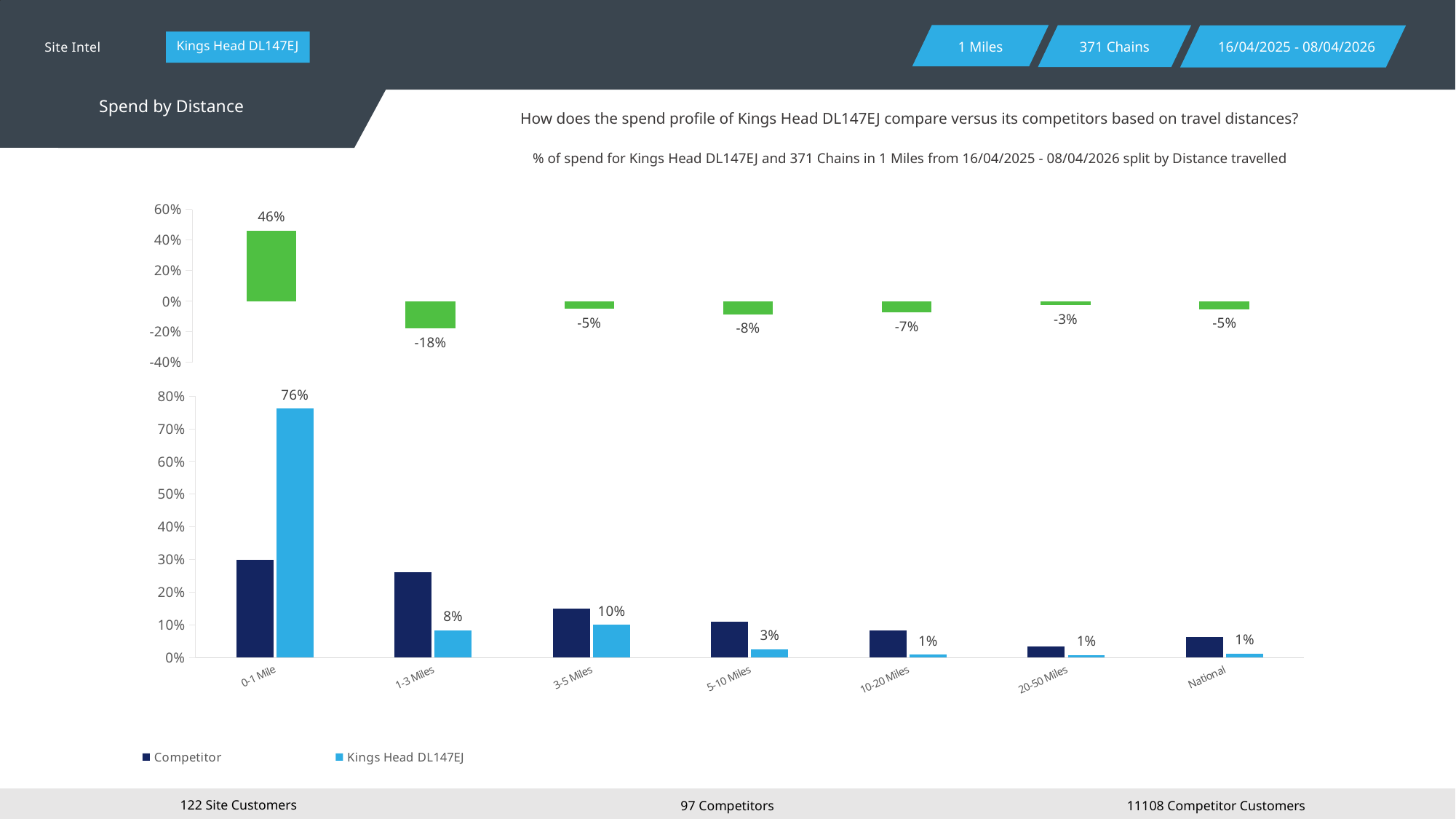
On the bottom chart, what is the value for Kings Head DL147EJ in the 0-1 Mile category? 76% On the bottom chart, in the 1-3 Miles category, which series has the larger value: Competitor or Kings Head DL147EJ? Competitor On the bottom chart, in the 0-1 Mile category, which series has the larger value: Competitor or Kings Head DL147EJ? Kings Head DL147EJ On the top green chart, what is the value of the first (leftmost) bar? 46% On the top green chart, what is the lowest value shown? -18% On the bottom chart, is the Competitor value for 0-1 Mile greater or less than 20%? greater On the bottom chart, what is the difference between the Kings Head DL147EJ values for 0-1 Mile and 1-3 Miles? 68 percentage points On the bottom chart, is the Competitor value for 3-5 Miles greater or less than 20%? less How many distance categories are shown on the bottom chart? 7 On the bottom chart, what is the value for Kings Head DL147EJ in the 3-5 Miles category? 10% How many series does the legend of the bottom chart list? 2 On the bottom chart, which distance category has the highest value for Kings Head DL147EJ? 0-1 Mile